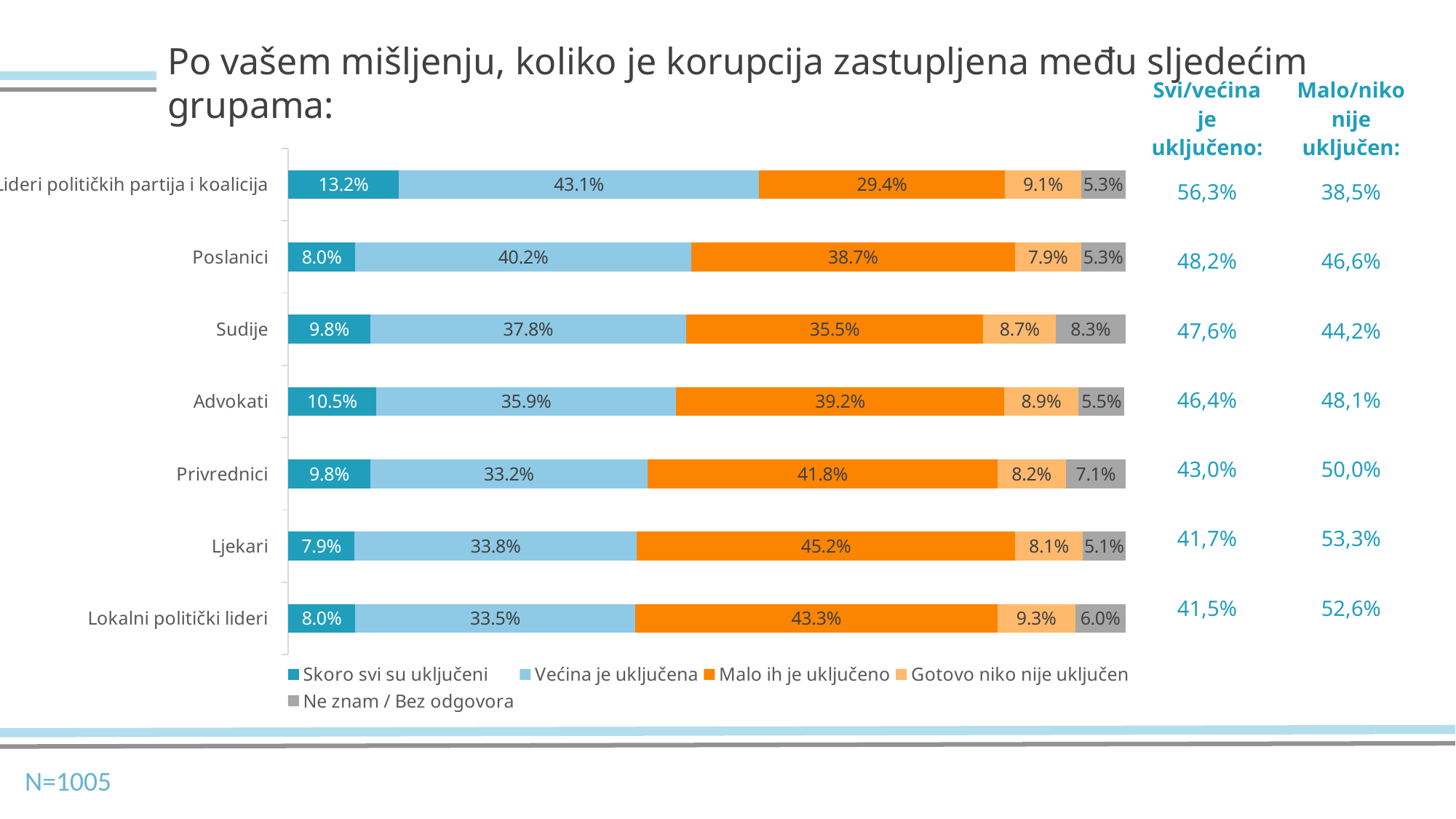
Which group has the highest 'Skoro svi su uključeni' value? Lideri političkih partija i koalicija How many series does the legend list? 5 Which group has the highest 'Malo ih je uključeno' value? Ljekari For Advokati, which is larger: 'Većina je uključena' or 'Malo ih je uključeno'? Malo ih je uključeno What is the difference in the 'Većina je uključena' value between Lideri političkih partija i koalicija and Lokalni politički lideri? 9.6 percentage points What is the sample size shown on the slide? N=1005 How many groups are shown on the chart? 7 What kind of chart is shown on the slide? Stacked bar chart What is the 'Malo ih je uključeno' value for Ljekari? 45.2% What percentage of respondents said 'Skoro svi su uključeni' for Lideri političkih partija i koalicija? 13.2% Which group has the lowest 'Ne znam / Bez odgovora' value? Ljekari What is the 'Ne znam / Bez odgovora' value for Sudije? 8.3%